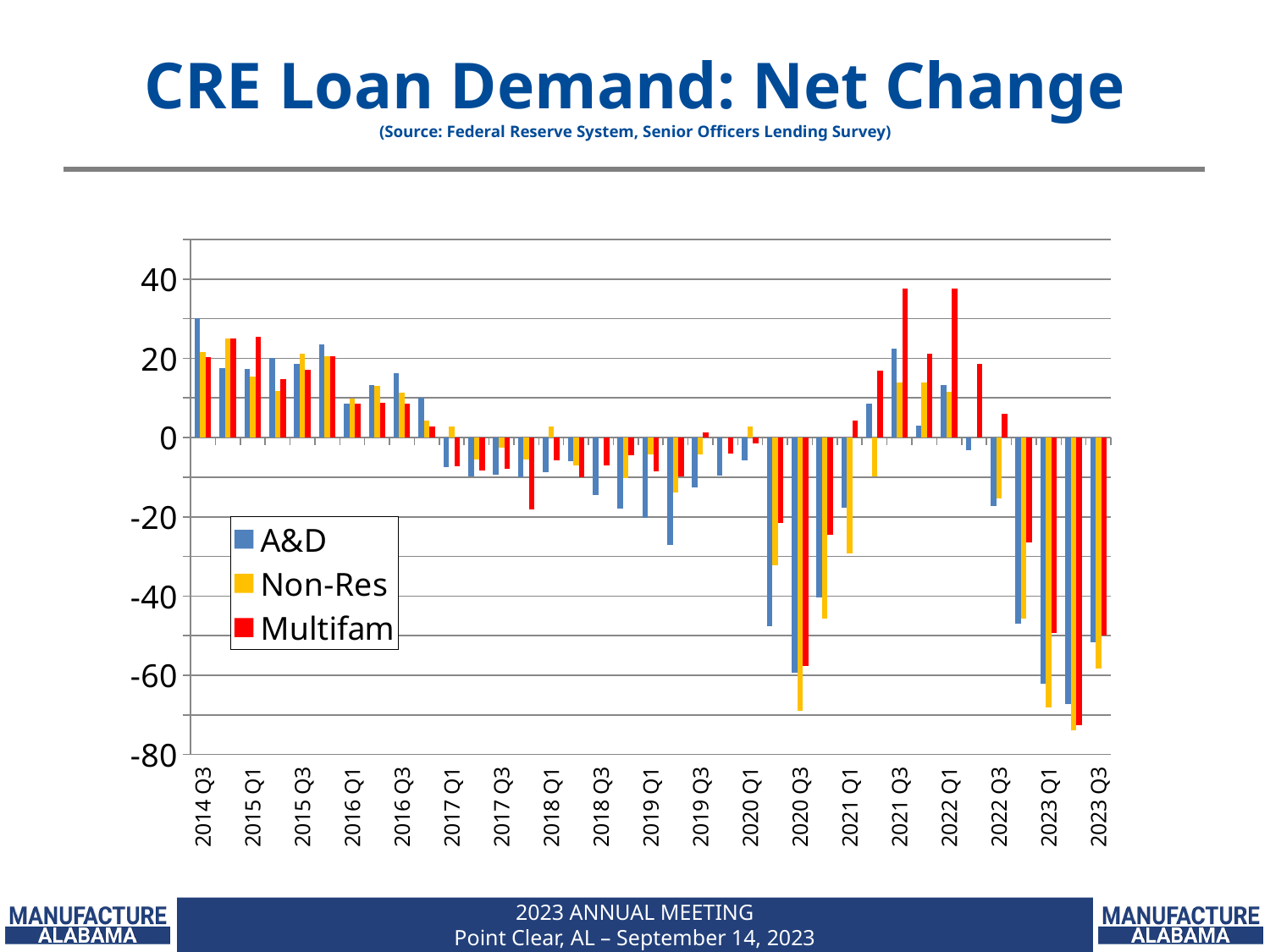
Is the value for A&D in 2014 Q3 greater or less than 20? greater How many series does the legend list? 3 What is the title of the chart? CRE Loan Demand: Net Change Do the A&D values rise or fall from 2014 Q3 to 2017 Q1? fall What are the three series named in the legend? A&D, Non-Res, Multifam Is the value for A&D in 2019 Q1 greater or less than -10? less In 2018 Q3, which is larger, the A&D value or the Non-Res value? Non-Res Is the value for Multifam in 2023 Q1 greater or less than -60? greater What kind of chart is shown on the slide? bar chart In 2014 Q3, which is larger, the A&D value or the Multifam value? A&D Which series has the lowest value in 2023 Q1? Non-Res